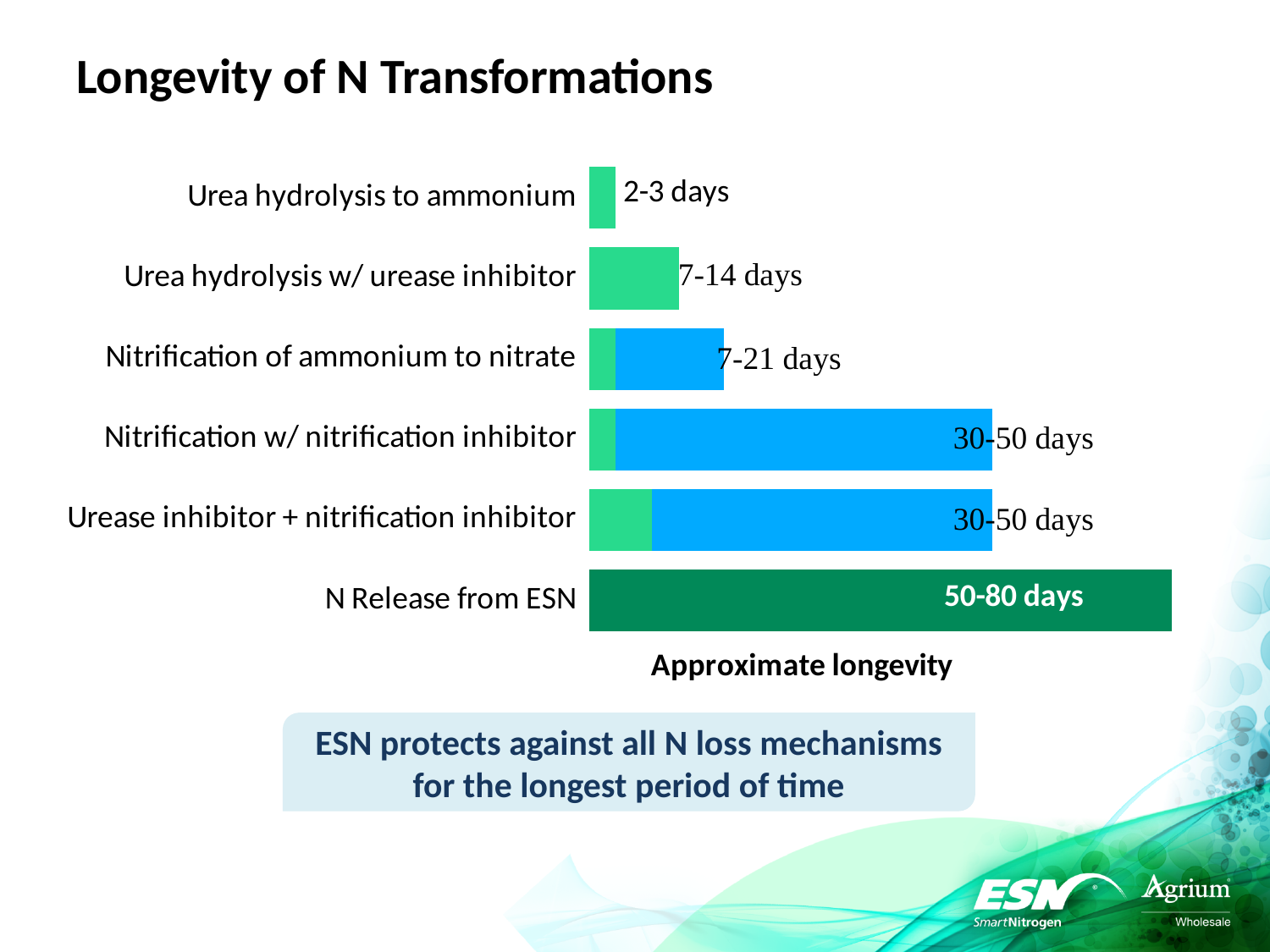
What is the approximate longevity shown for Urea hydrolysis w/ urease inhibitor? 7-14 days What is the approximate longevity shown for Urea hydrolysis to ammonium? 2-3 days What is the title of the chart on the slide? Longevity of N Transformations Which has the longer approximate longevity: N Release from ESN or Urea hydrolysis w/ urease inhibitor? N Release from ESN What label appears beneath the bars of the chart? Approximate longevity What kind of chart is shown on the slide? bar chart What is the approximate longevity shown for Nitrification of ammonium to nitrate? 7-21 days What is the approximate longevity shown for N Release from ESN? 50-80 days What is the approximate longevity shown for Nitrification w/ nitrification inhibitor? 30-50 days Which category has the shortest bar in the chart? Urea hydrolysis to ammonium Which category has the longest bar in the chart? N Release from ESN How many categories (bars) does the chart show? 6